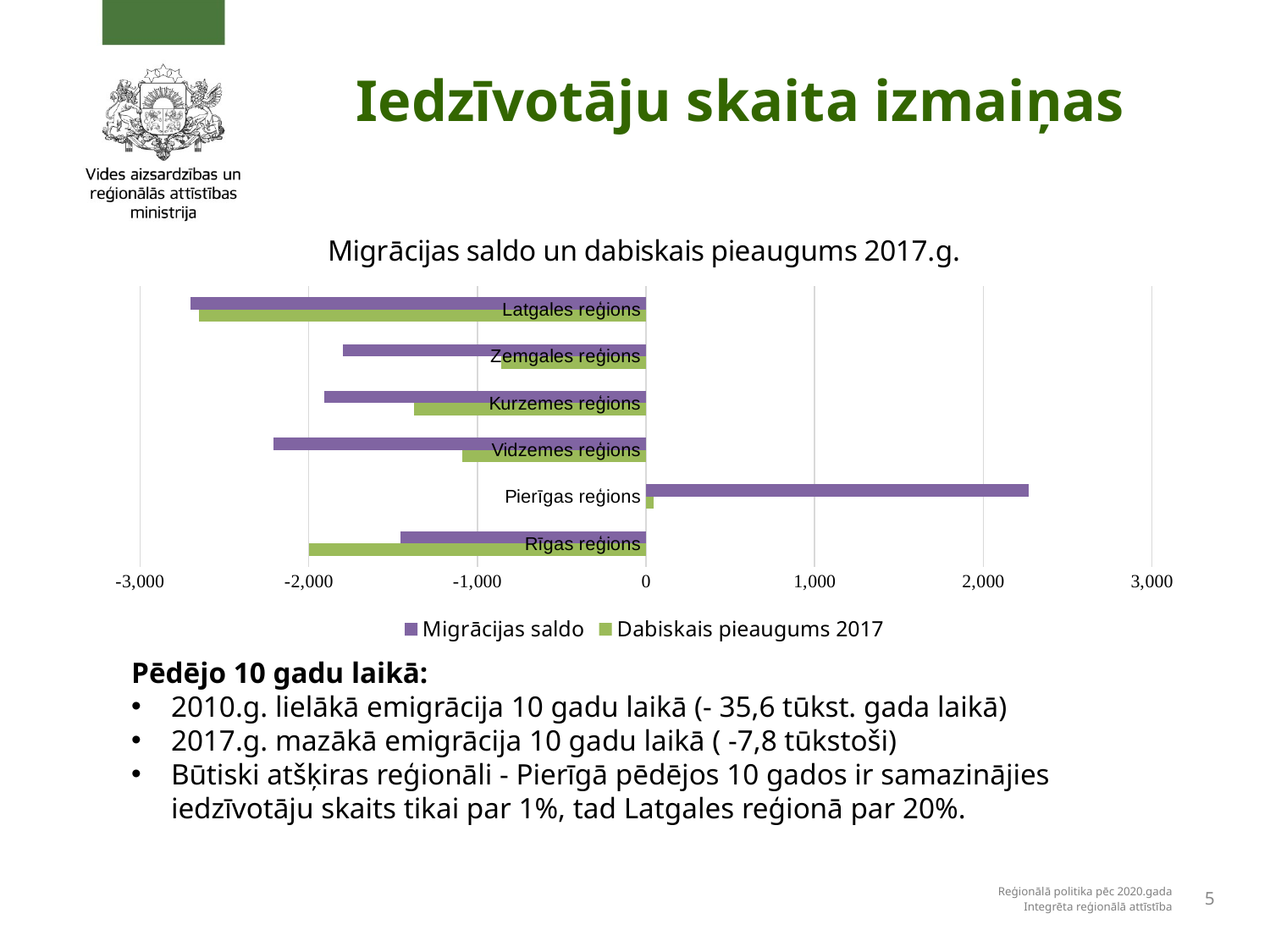
Which is larger for Rīgas reģions: the Migrācijas saldo value or the Dabiskais pieaugums 2017 value? Migrācijas saldo Which region has the lowest Migrācijas saldo value? Latgales reģions What kind of chart is shown on the slide? bar chart Is the Dabiskais pieaugums 2017 value for Kurzemes reģions greater or less than -1,000? less How many regions are plotted on the chart? 6 Which region has the lowest Dabiskais pieaugums 2017 value? Latgales reģions How many series does the chart legend list? 2 Is the Migrācijas saldo value for Vidzemes reģions greater or less than -2,000? less Which region is the only one with a positive Migrācijas saldo value? Pierīgas reģions Is the Migrācijas saldo value for Pierīgas reģions greater or less than 2,000? greater Which region has the highest Migrācijas saldo value? Pierīgas reģions What is the title of the chart? Migrācijas saldo un dabiskais pieaugums 2017.g.